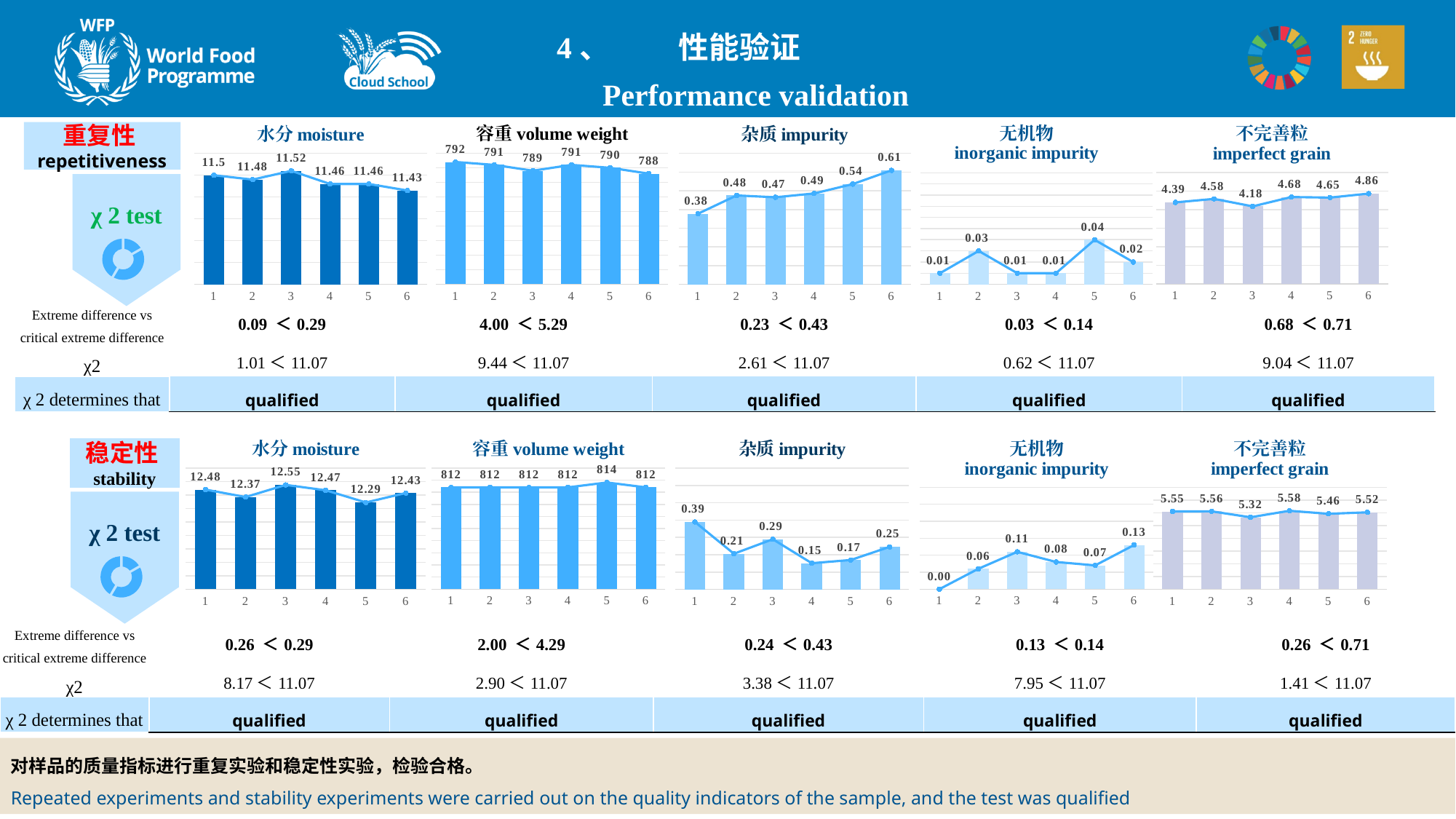
In the stability row, what is the value at point 1 in the inorganic impurity chart? 0.00 In the stability row, what is the value at point 5 in the volume weight chart? 814 In the repetitiveness row, what is the value at point 3 in the moisture chart? 11.52 In the repetitiveness row, what is the difference between point 5 and point 1 in the inorganic impurity chart? 0.03 In the repetitiveness row, which point has the highest value in the impurity chart? 6 How many points are plotted in the repetitiveness moisture chart? 6 In the repetitiveness row, what is the lowest value in the volume weight chart? 788 Do the values in the repetitiveness impurity chart generally rise or fall from point 1 to point 6? Rise In the stability row, what is the difference between point 1 and point 4 in the impurity chart? 0.24 In the repetitiveness row, which is larger in the imperfect grain chart: point 4 or point 3? Point 4 In the stability row, which point has the lowest value in the moisture chart? 5 In the stability row, which point has the highest value in the imperfect grain chart? 4